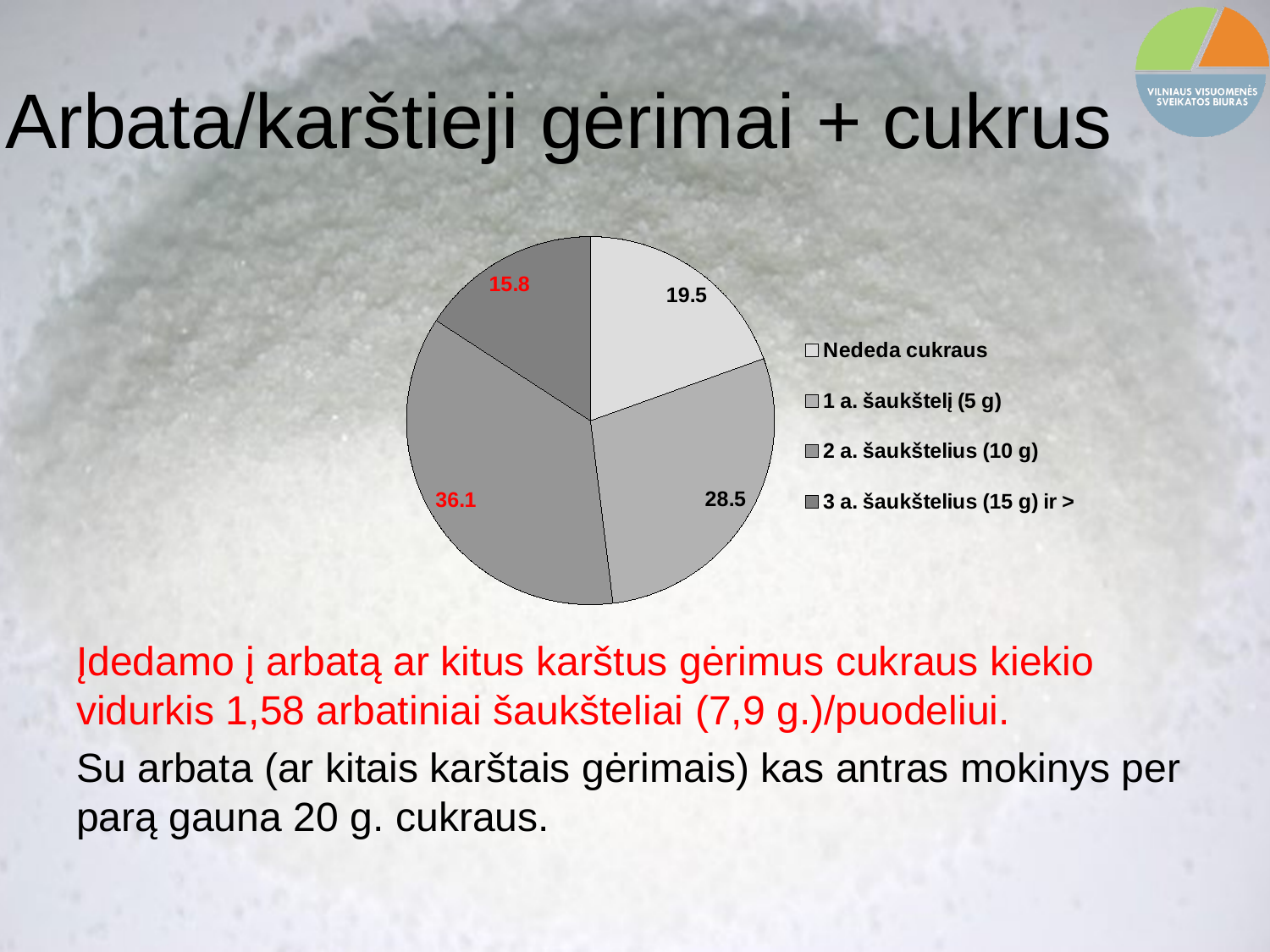
What is the value for the '2 a. šaukštelius (10 g)' slice? 36.1 Which is larger: the '1 a. šaukštelį (5 g)' slice or the '3 a. šaukštelius (15 g) ir >' slice? 1 a. šaukštelį (5 g) What is the value for the '1 a. šaukštelį (5 g)' slice? 28.5 Which legend entry is shown with the darkest shade in the pie chart? 3 a. šaukštelius (15 g) ir > What is the value for the 'Nededa cukraus' slice? 19.5 What is the difference between the '2 a. šaukštelius (10 g)' slice and the 'Nededa cukraus' slice? 16.6 Which category has the smallest slice of the pie? 3 a. šaukštelius (15 g) ir > How many entries does the legend list? 4 What is the value for the '3 a. šaukštelius (15 g) ir >' slice? 15.8 How many slices does the pie chart have? 4 What kind of chart is shown on the slide? pie chart Which category has the largest slice of the pie? 2 a. šaukštelius (10 g)